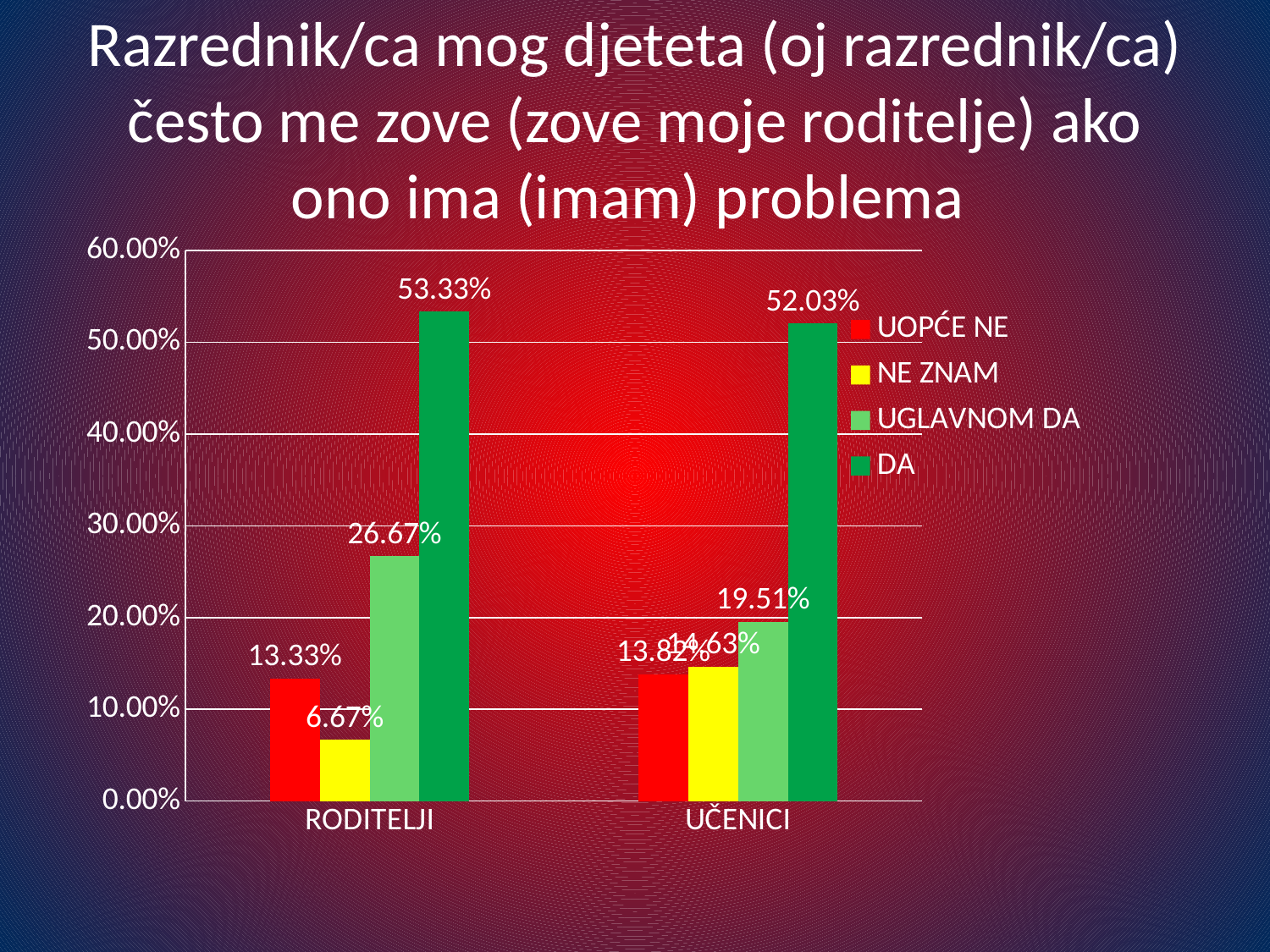
How many series does the legend list? 4 What kind of chart is shown on the slide? bar chart What is the value for DA in the RODITELJI category? 53.33% How many categories are shown on the x axis? 2 Which series has the lowest value in the RODITELJI category? NE ZNAM What is the value for DA in the UČENICI category? 52.03% Which series has the highest value in the RODITELJI category? DA Is the value for UOPĆE NE in the UČENICI category greater or less than 10.00%? greater What is the value for UGLAVNOM DA in the UČENICI category? 19.51% What is the difference between the DA values for RODITELJI and UČENICI? 1.30% What is the value for NE ZNAM in the RODITELJI category? 6.67% Which is larger: UGLAVNOM DA for RODITELJI or UGLAVNOM DA for UČENICI? RODITELJI